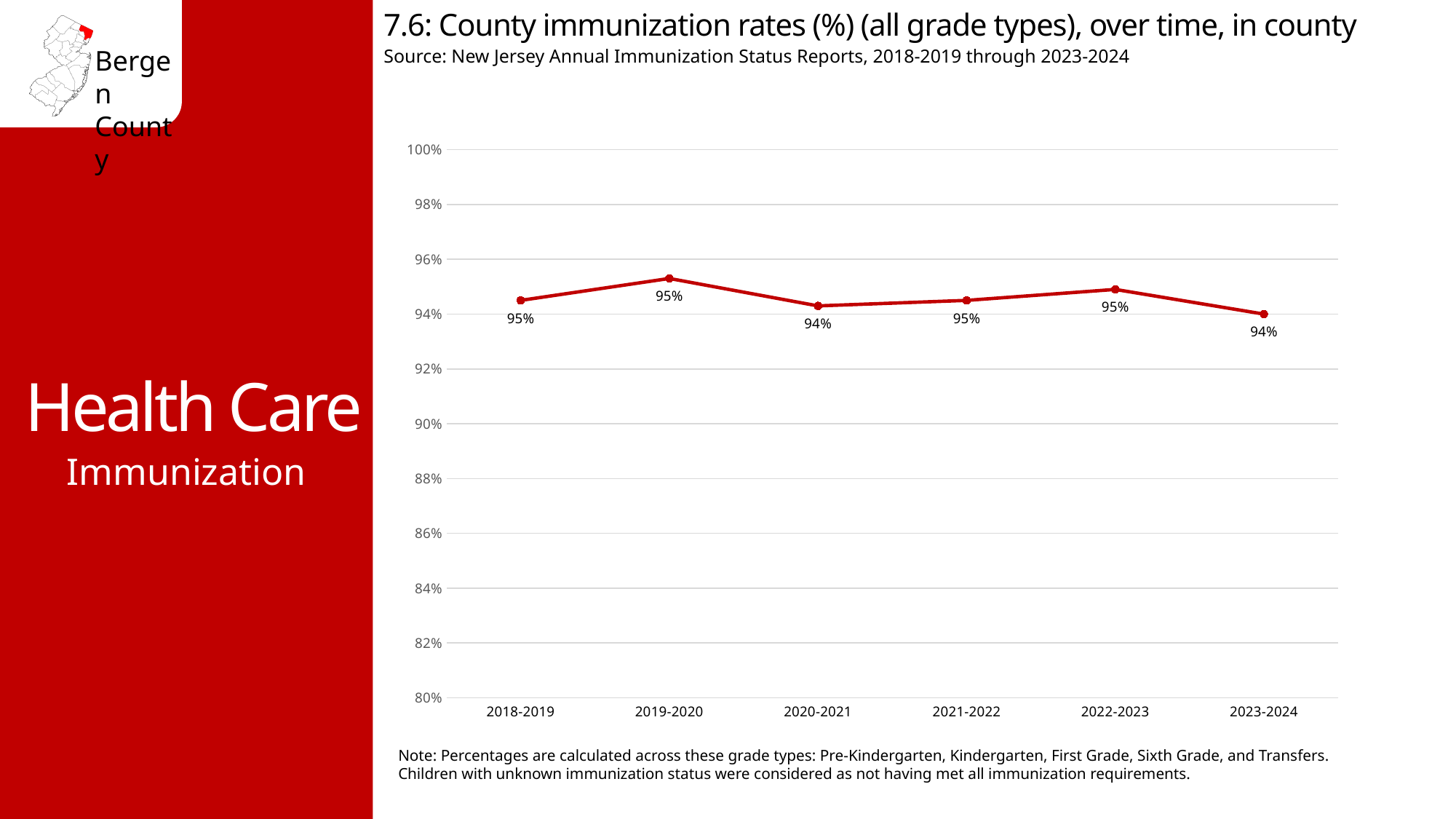
What is the county immunization rate for 2022-2023? 95% How many school years are plotted on the chart? 6 Is the immunization rate for 2023-2024 greater or less than 96%? less Is the immunization rate for 2019-2020 greater or less than 94%? greater What kind of chart is shown on the slide? Line chart What is the county immunization rate for 2020-2021? 94% What is the county immunization rate for 2018-2019? 95% Which school year has the highest plotted immunization rate? 2019-2020 Which is larger, the immunization rate for 2019-2020 or for 2023-2024? 2019-2020 What is the county immunization rate for 2023-2024? 94% Which school year has the lowest plotted immunization rate? 2023-2024 What is the difference between the labelled immunization rates for 2018-2019 and 2020-2021? 1%